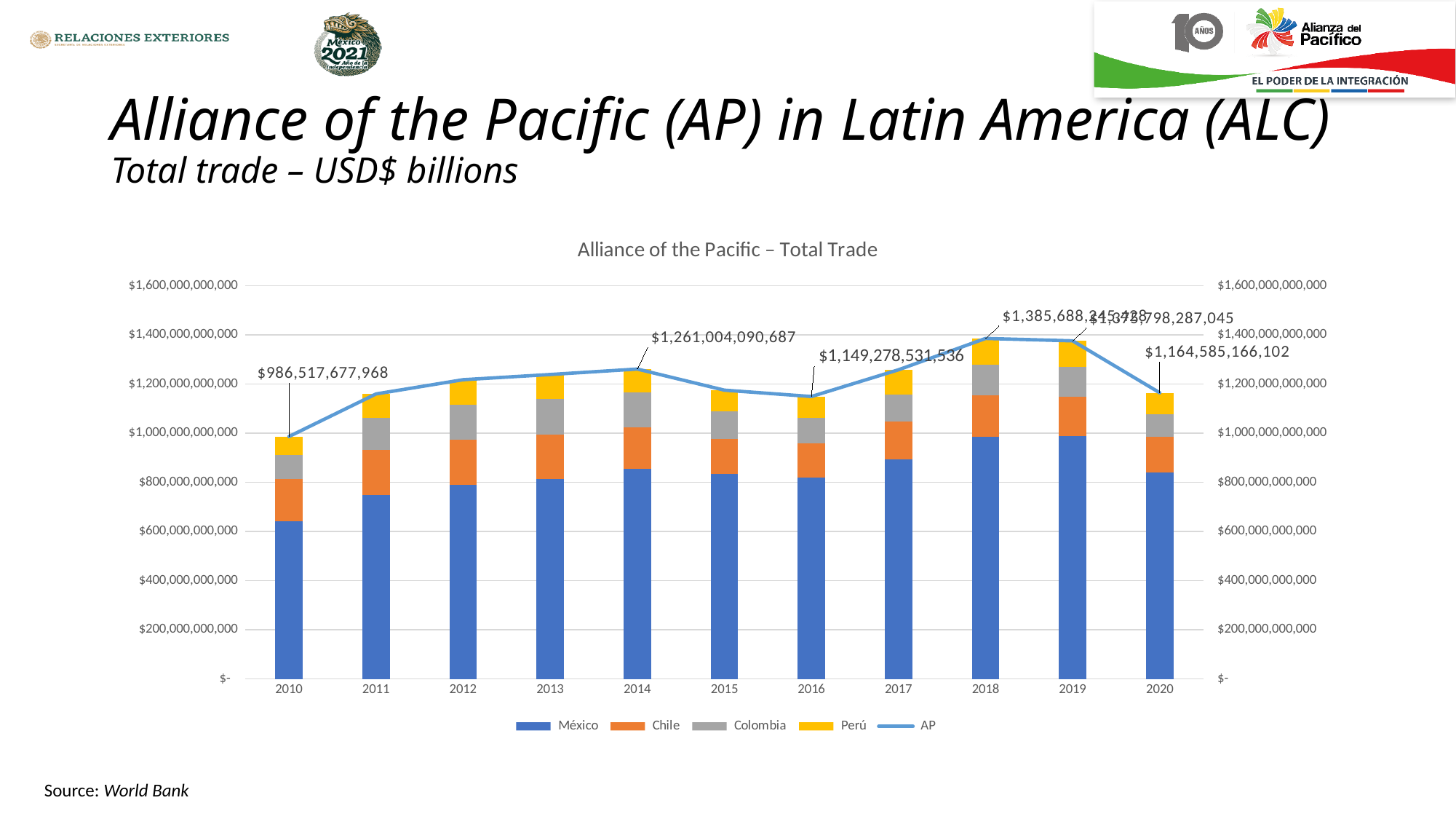
Which year has the larger labelled AP value, 2016 or 2020? 2020 How many series does the legend list? 5 What kind of chart is shown on the slide? A stacked bar chart with a line What is the AP total trade value labelled for 2014? $1,261,004,090,687 By how much did the labelled AP value increase from 2010 to 2014? $274,486,412,719 How many years are shown on the x axis? 11 What is the AP total trade value labelled for 2020? $1,164,585,166,102 Which year has the lowest AP total trade value? 2010 What is the AP total trade value labelled for 2010? $986,517,677,968 Is the value for México in 2010 greater or less than $800,000,000,000? less What is the AP total trade value labelled for 2016? $1,149,278,531,536 Does the AP line rise or fall from 2010 to 2014? rise